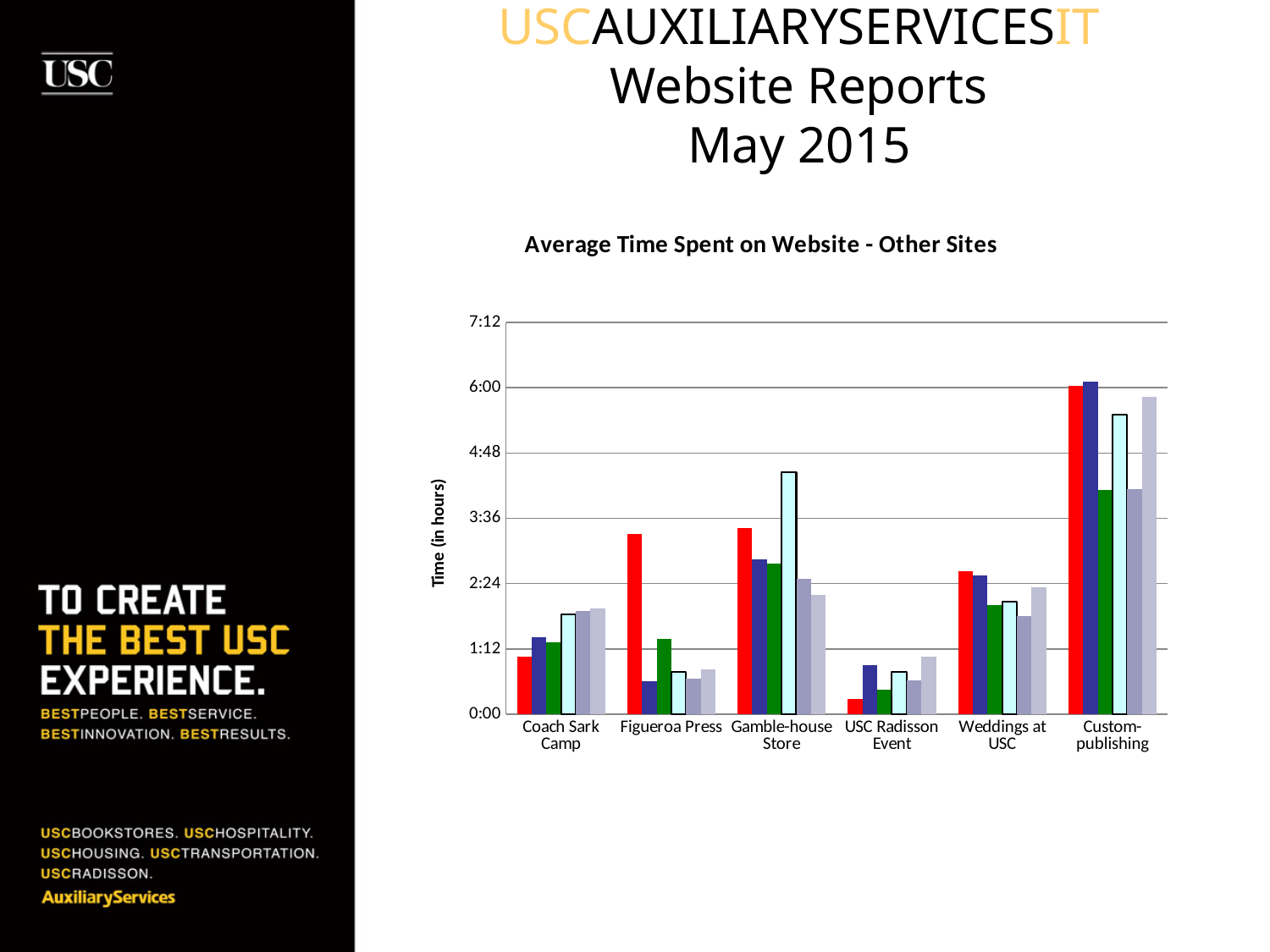
How many website categories are shown along the x axis? 6 What is the title of the chart? Average Time Spent on Website - Other Sites Is the green bar for Custom-publishing greater or less than 3:36? greater Which website category has the shortest bars overall? USC Radisson Event What kind of chart is shown on the slide? bar chart What is the label on the vertical axis of the chart? Time (in hours) Is the red bar for Coach Sark Camp greater or less than 2:24? less Is the light cyan bar for Gamble-house Store greater or less than 3:36? greater Which website category has the tallest bars overall? Custom-publishing Which is larger, the red bar for Figueroa Press or the red bar for USC Radisson Event? Figueroa Press How many bars are plotted for each website category? 6